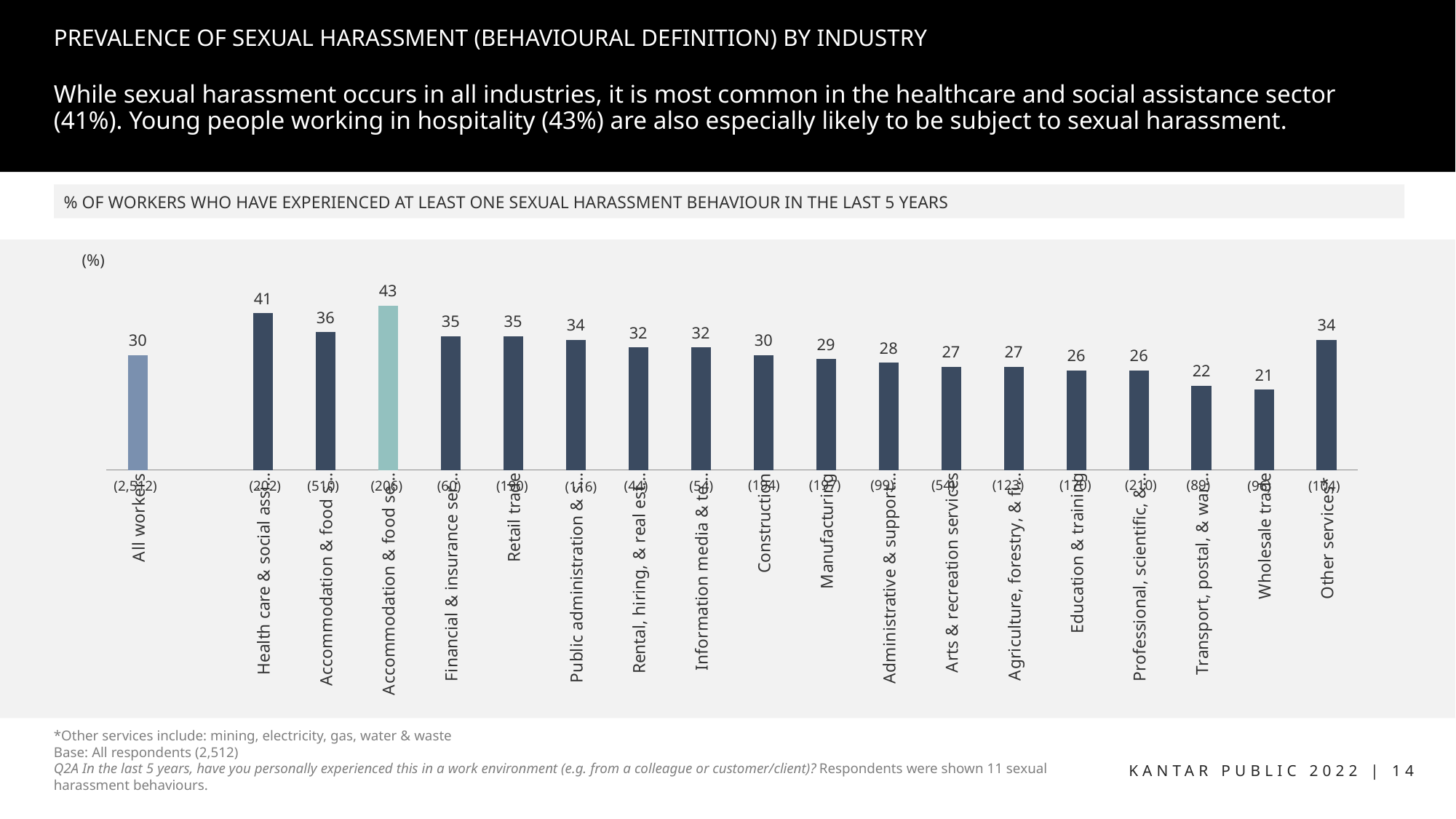
What is the value for Wholesale trade? 21 What is the value for Construction? 30 Which industry has the lowest value? Wholesale trade What kind of chart is shown on the slide? Bar chart How many bars are shown on the chart? 19 What is the value for All workers? 30 What is the difference between the value for Transport, postal, & warehousing and the value for Wholesale trade? 1 Which is larger, the value for Retail trade or the value for Education & training? Retail trade What is the value for Manufacturing? 29 What is the highest value shown on the chart? 43 What is the value for Other services? 34 What is the difference between the value for Health care & social assistance and the value for All workers? 11